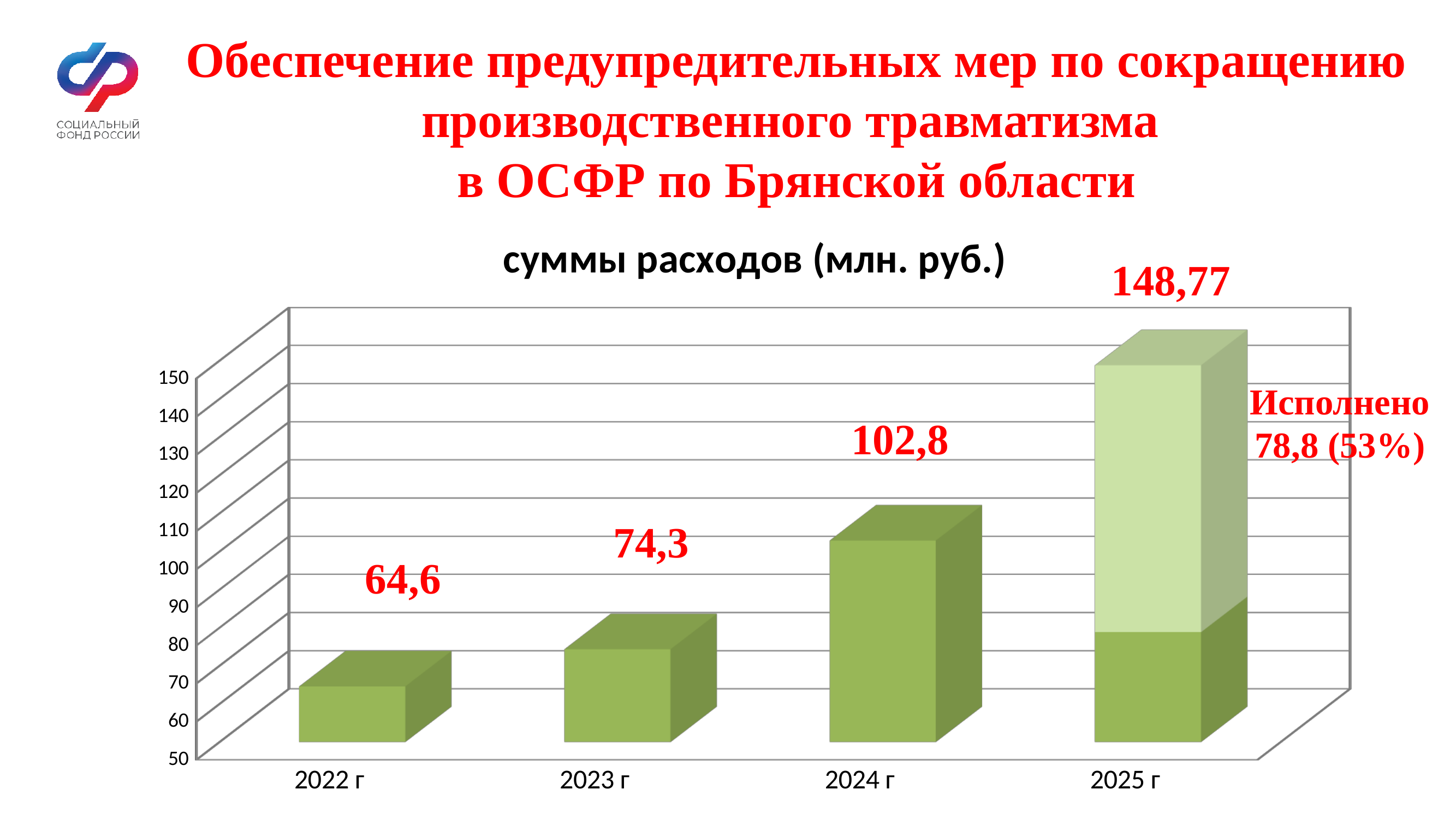
What is the value for 2024 г? 102,8 What is the value for 2022 г? 64,6 What is the difference between the values for 2024 г and 2023 г? 28,5 Which year has the highest value? 2025 г How many years are shown on the x axis? 4 What is the value for 2025 г? 148,77 Do the values rise or fall from 2022 г to 2025 г? rise What is the difference between the values for 2025 г and 2022 г? 84,17 Which year has the lowest value? 2022 г Is the value for 2024 г greater or less than 100? greater What kind of chart is shown on the slide? bar chart Which is larger, the value for 2023 г or the value for 2024 г? 2024 г